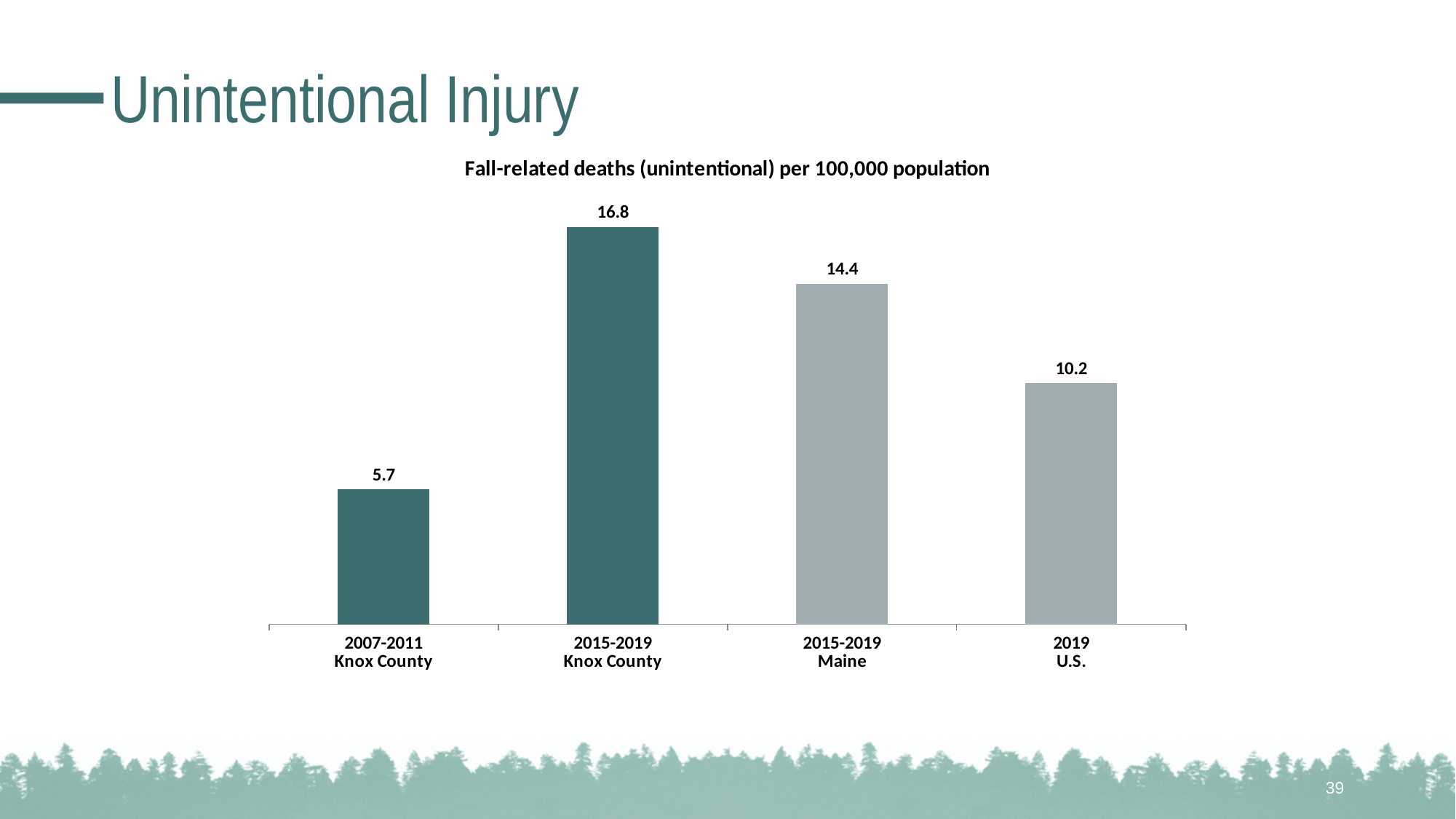
What is the value for 2015-2019 Knox County? 16.8 What is the difference between the 2015-2019 Maine value and the 2019 U.S. value? 4.2 What is the value for 2007-2011 Knox County? 5.7 What is the difference between the 2015-2019 Knox County value and the 2007-2011 Knox County value? 11.1 Which category has the highest value? 2015-2019 Knox County How many bars are shown in the chart? 4 What is the title of the chart? Fall-related deaths (unintentional) per 100,000 population What is the value for 2019 U.S.? 10.2 What is the value for 2015-2019 Maine? 14.4 What kind of chart is shown on the slide? Bar chart Which category has the lowest value? 2007-2011 Knox County Which is larger, the value for 2015-2019 Maine or the value for 2019 U.S.? 2015-2019 Maine